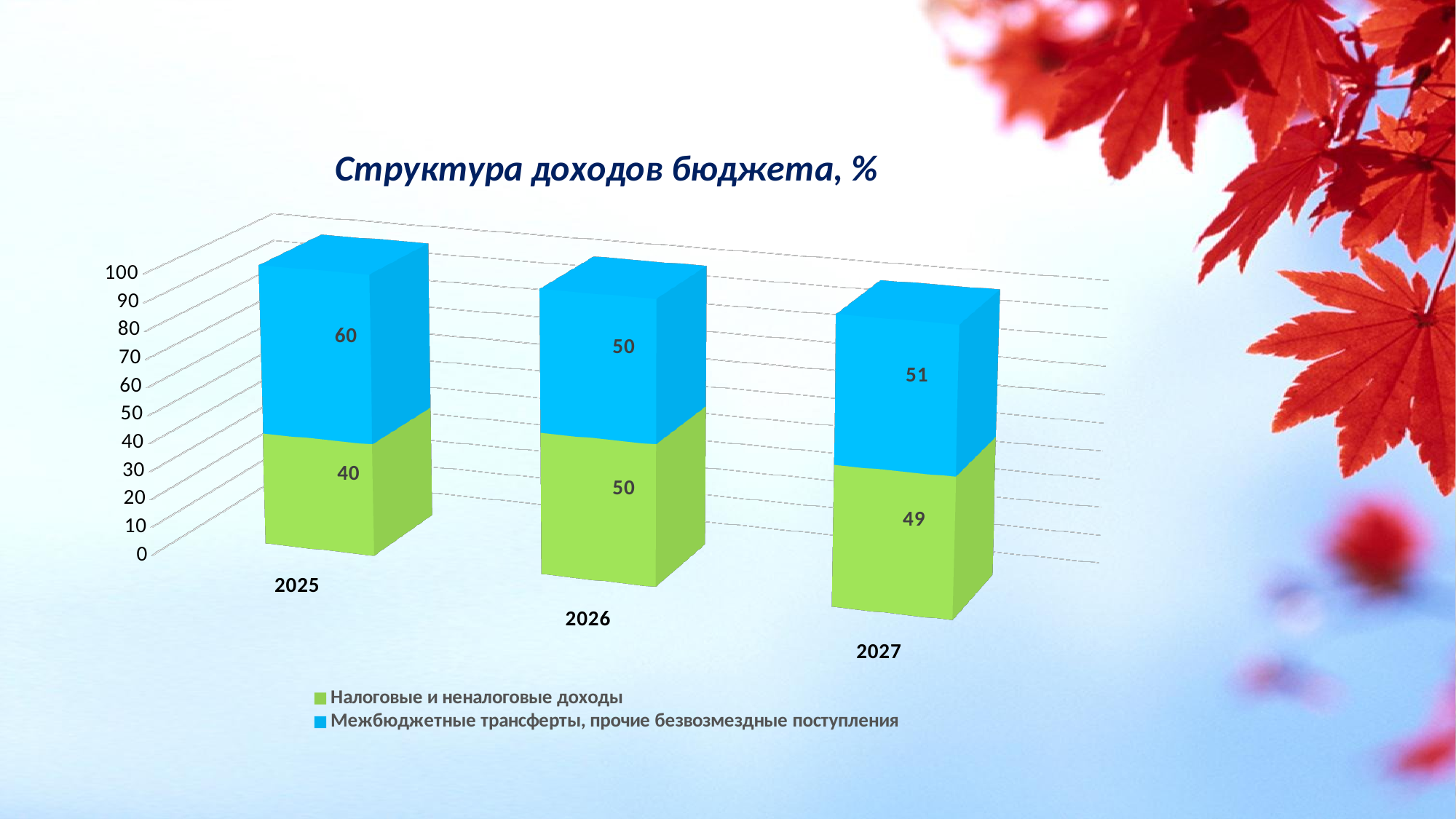
How many years are shown on the x axis? 3 What is the difference between the two series' values in 2025? 20 In which year is the value for "Налоговые и неналоговые доходы" lowest? 2025 What is the value for "Налоговые и неналоговые доходы" in 2026? 50 In 2027, which series has the larger value? Межбюджетные трансферты, прочие безвозмездные поступления How many series does the legend list? 2 What is the title of the chart? Структура доходов бюджета, % In which year is the value for "Межбюджетные трансферты, прочие безвозмездные поступления" highest? 2025 What is the total of the stacked bar for 2026? 100 What is the value for "Налоговые и неналоговые доходы" in 2025? 40 What kind of chart is shown on the slide? Stacked bar chart What is the value for "Межбюджетные трансферты, прочие безвозмездные поступления" in 2027? 51